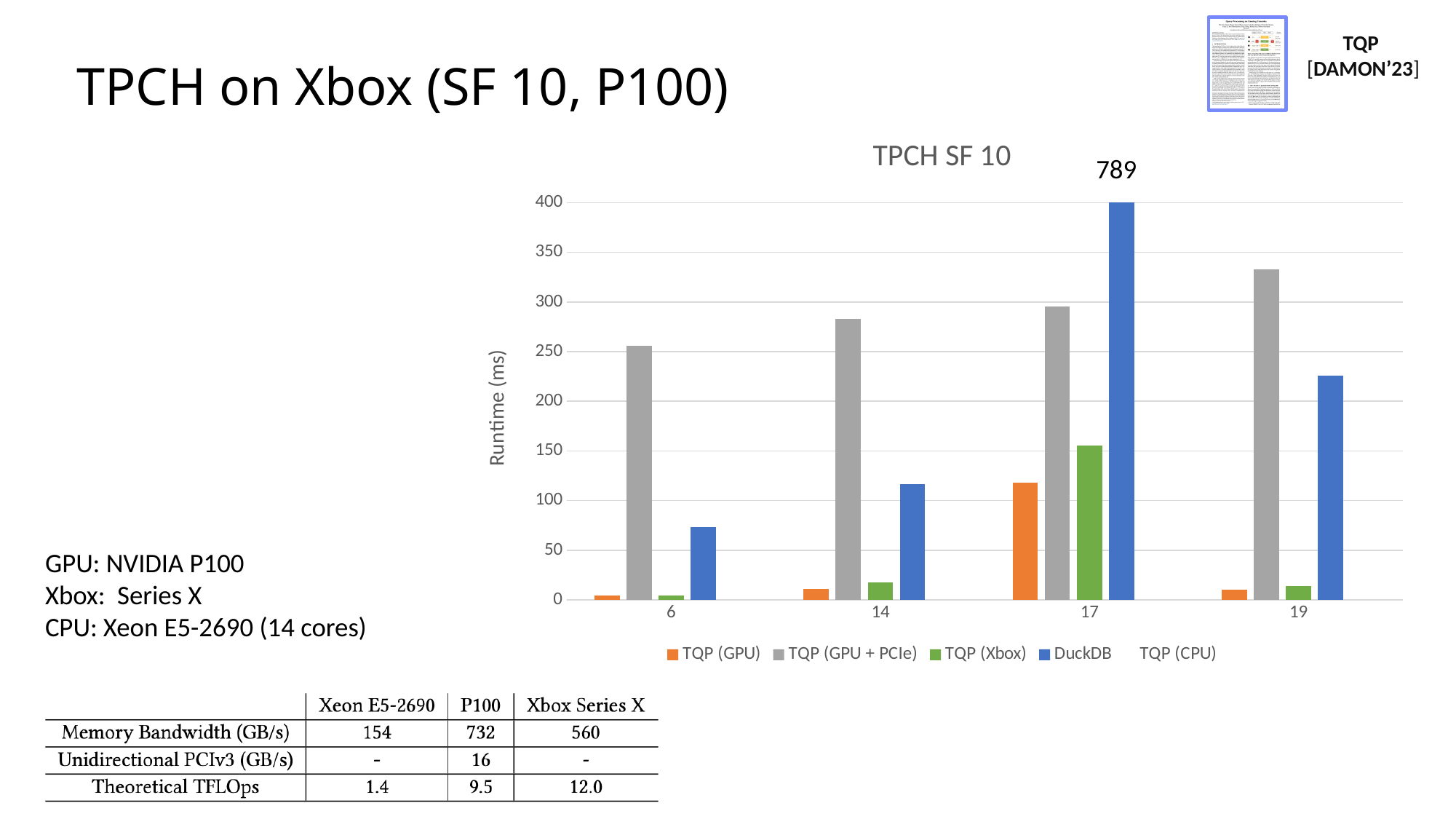
Which query has the highest DuckDB runtime in the TPCH SF 10 chart? 17 How many series does the legend of the TPCH SF 10 chart list? 5 For query 17, which is larger: the TQP (GPU) runtime or the TQP (Xbox) runtime? TQP (Xbox) What is the DuckDB runtime for query 17 in the TPCH SF 10 chart? 789 Is the TQP (Xbox) runtime for query 17 greater or less than 100? greater What is the label on the y axis of the TPCH SF 10 chart? Runtime (ms) For query 14, which is larger: the DuckDB runtime or the TQP (GPU + PCIe) runtime? TQP (GPU + PCIe) Which query has the lowest TQP (GPU + PCIe) runtime in the TPCH SF 10 chart? 6 Is the TQP (GPU + PCIe) runtime for query 19 greater or less than 300? greater How many query categories are shown on the x axis of the TPCH SF 10 chart? 4 Is the DuckDB runtime for query 6 greater or less than 100? less What kind of chart is shown on the slide? bar chart